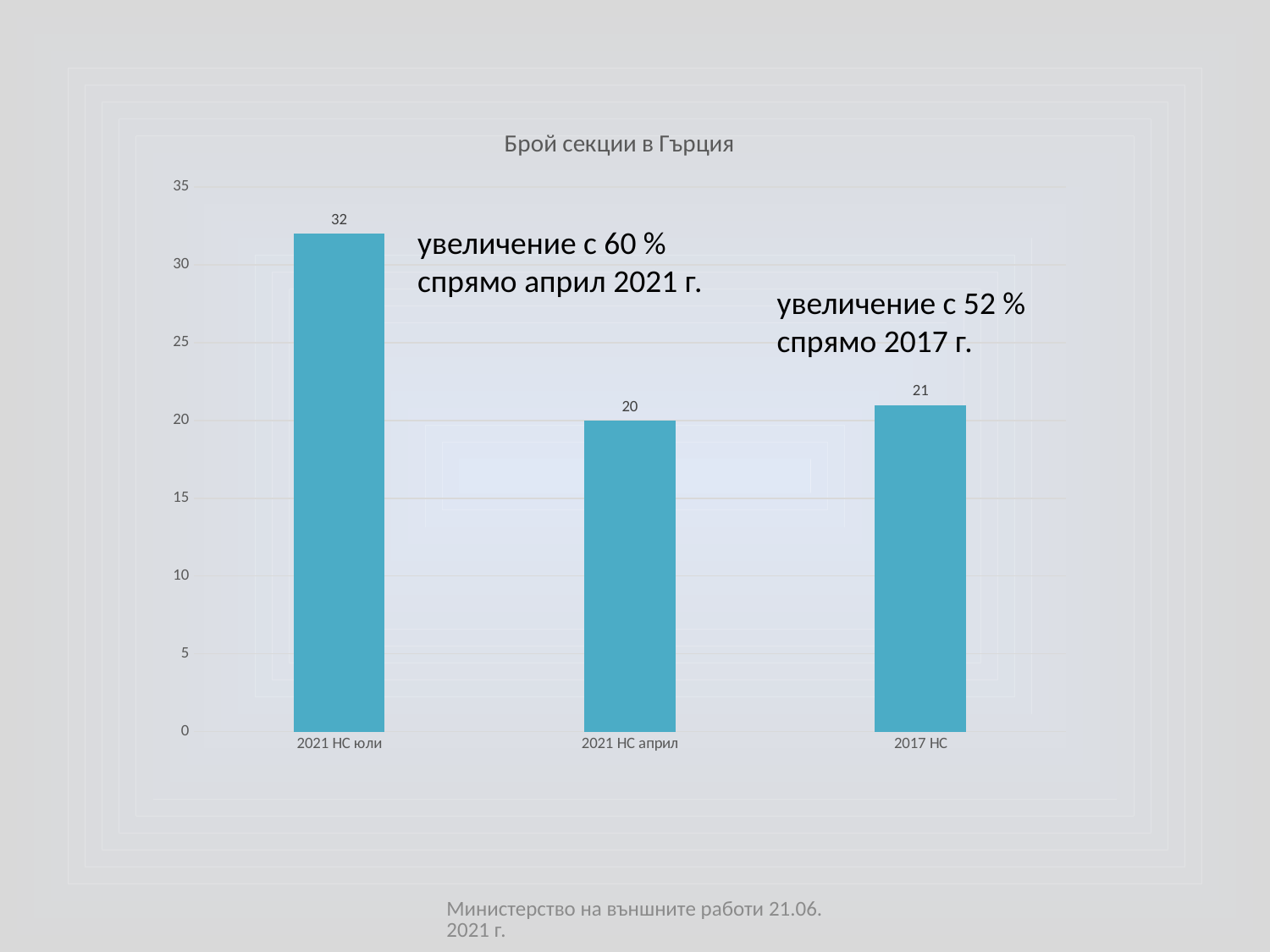
Which is larger, the value for 2021 НС юли or the value for 2017 НС? 2021 НС юли How many categories are shown on the x axis? 3 What is the difference between the values for 2021 НС юли and 2021 НС април? 12 What is the value for 2021 НС април? 20 Which category has the lowest value? 2021 НС април Which category has the highest value? 2021 НС юли What is the value for 2021 НС юли? 32 Is the value for 2021 НС юли greater or less than 30? greater What is the difference between the values for 2021 НС юли and 2017 НС? 11 What is the value for 2017 НС? 21 What is the title of the chart? Брой секции в Гърция What kind of chart is shown on the slide? bar chart